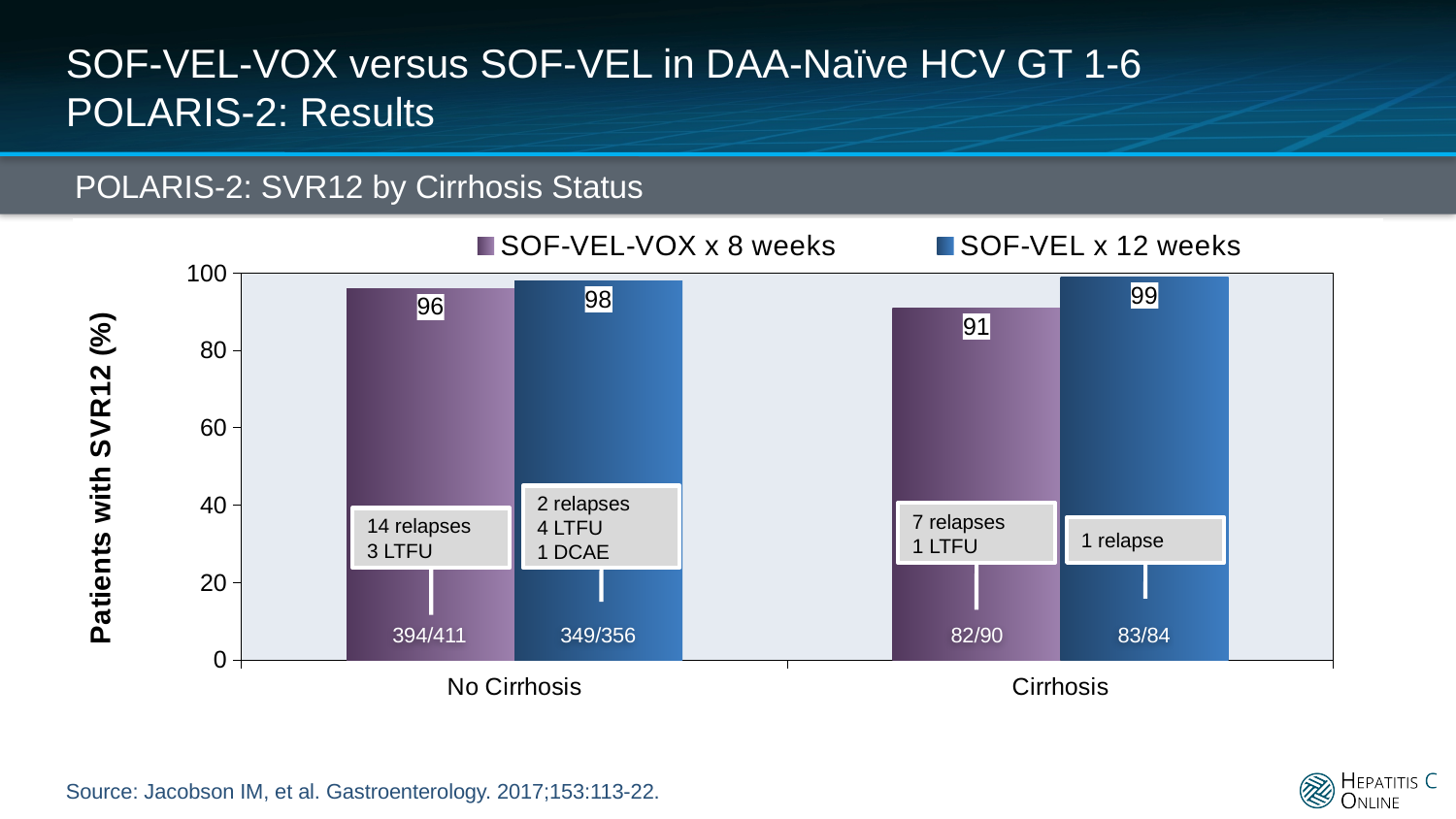
What is the SVR12 rate for SOF-VEL-VOX x 8 weeks in the No Cirrhosis group? 96 What is the SVR12 rate for SOF-VEL x 12 weeks in the No Cirrhosis group? 98 In the No Cirrhosis group, which regimen has the higher SVR12 rate? SOF-VEL x 12 weeks Which bar has the highest SVR12 rate? SOF-VEL x 12 weeks, Cirrhosis How many series does the legend list? 2 How many categories are shown on the x axis? 2 Which bar has the lowest SVR12 rate? SOF-VEL-VOX x 8 weeks, Cirrhosis What is the SVR12 rate for SOF-VEL x 12 weeks in the Cirrhosis group? 99 What type of chart is shown? Bar chart What is the fraction of patients shown for SOF-VEL-VOX x 8 weeks in the No Cirrhosis group? 394/411 What is the SVR12 rate for SOF-VEL-VOX x 8 weeks in the Cirrhosis group? 91 What is the difference in SVR12 rate between SOF-VEL x 12 weeks and SOF-VEL-VOX x 8 weeks in the Cirrhosis group? 8